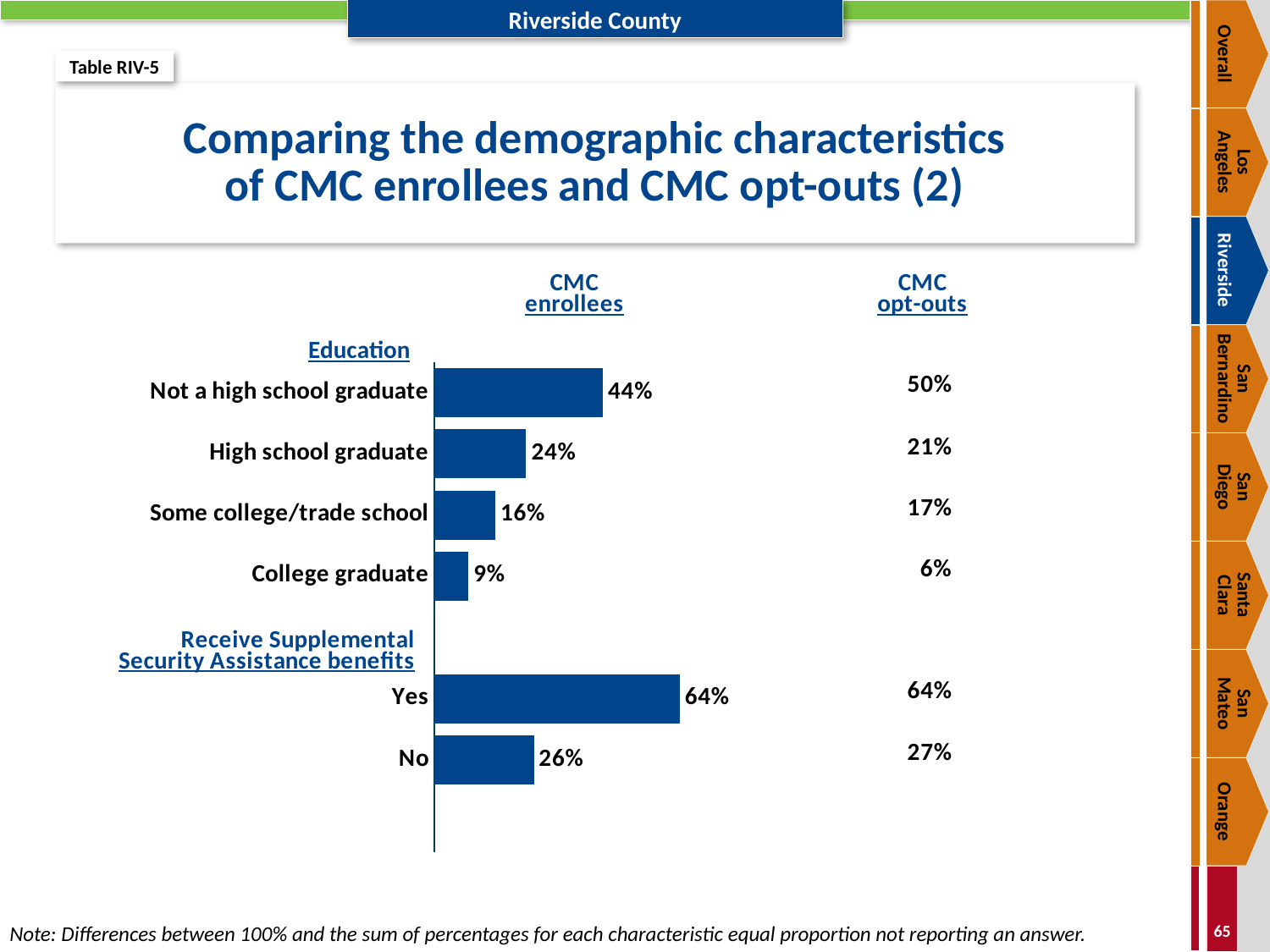
What percentage of CMC enrollees are college graduates? 9% What is the difference between the CMC enrollee percentages for 'Yes' and 'No' on receiving Supplemental Security Assistance benefits? 38% Among the Education categories, which has the lowest percentage of CMC enrollees? College graduate What percentage of CMC opt-outs are not a high school graduate? 50% What percentage of CMC enrollees are not a high school graduate? 44% What type of chart is used to show the CMC enrollees percentages? Bar chart Among the Education categories, which has the highest percentage of CMC enrollees? Not a high school graduate What is the difference between the CMC enrollee percentages for 'Not a high school graduate' and 'High school graduate'? 20% How many bars are plotted in the CMC enrollees chart? 6 What percentage of CMC enrollees receive Supplemental Security Assistance benefits (Yes)? 64% What is the title of the slide's chart? Comparing the demographic characteristics of CMC enrollees and CMC opt-outs (2) Which is larger for CMC enrollees: 'High school graduate' or 'Some college/trade school'? High school graduate